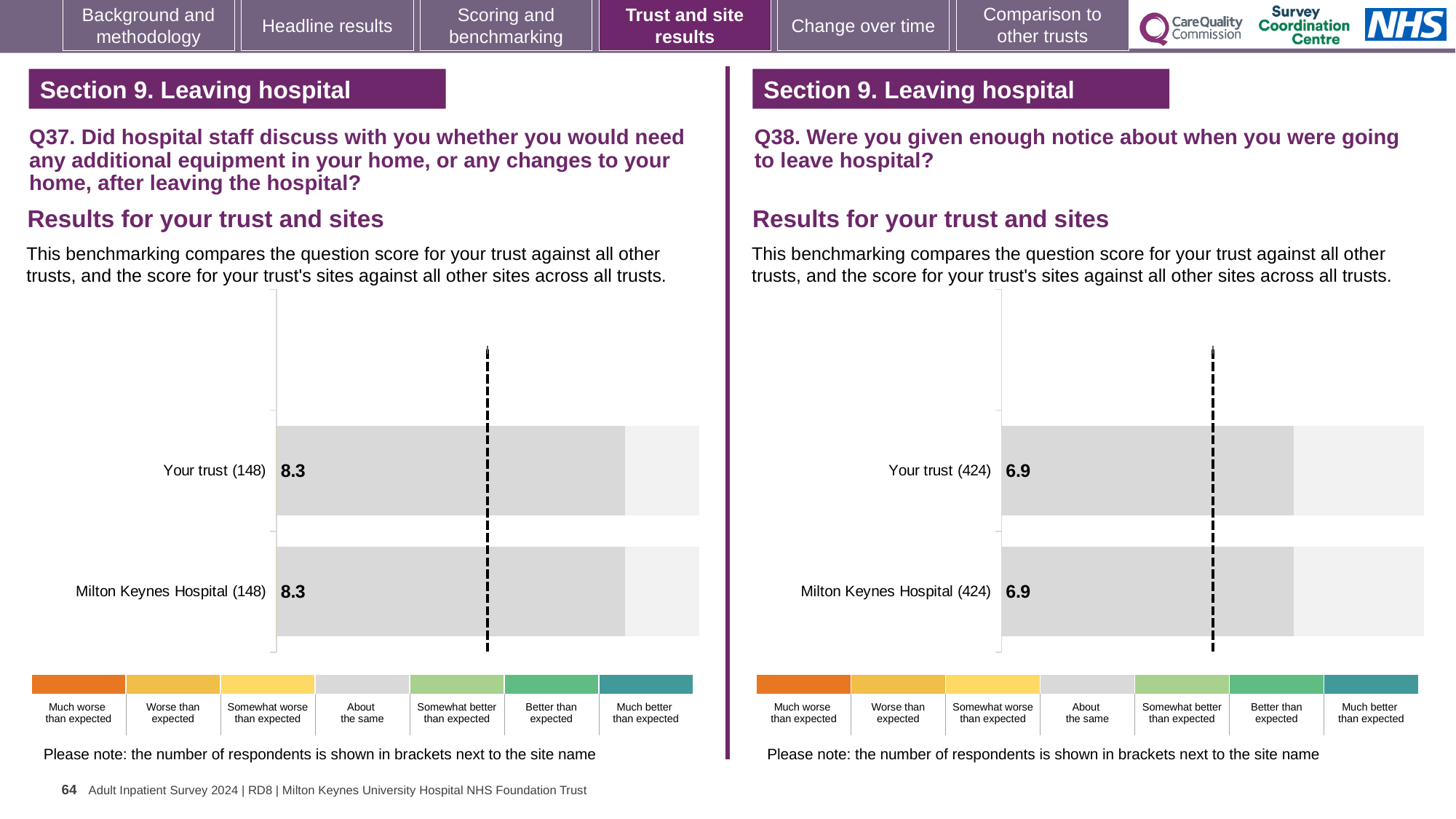
How many bars are plotted on the Q37 chart (left)? 2 Is the score for Your trust on the Q37 chart (left) larger or smaller than the score for Your trust on the Q38 chart (right)? Larger On the Q37 chart (left), what is the score for Your trust? 8.3 On the Q37 chart (left), what is the difference between the score for Your trust and the score for Milton Keynes Hospital? 0 On the Q38 chart (right), what is the score for Your trust? 6.9 On the Q38 chart (right), what is the difference between the score for Your trust and the score for Milton Keynes Hospital? 0 On the Q37 chart (left), how many respondents are shown in brackets for Milton Keynes Hospital? 148 On the Q38 chart (right), what is the score for Milton Keynes Hospital? 6.9 How many bars are plotted on the Q38 chart (right)? 2 On the Q37 chart (left), what is the score for Milton Keynes Hospital? 8.3 What kind of chart is used on the Q38 chart (right)? Bar chart On the Q38 chart (right), how many respondents are shown in brackets for Your trust? 424